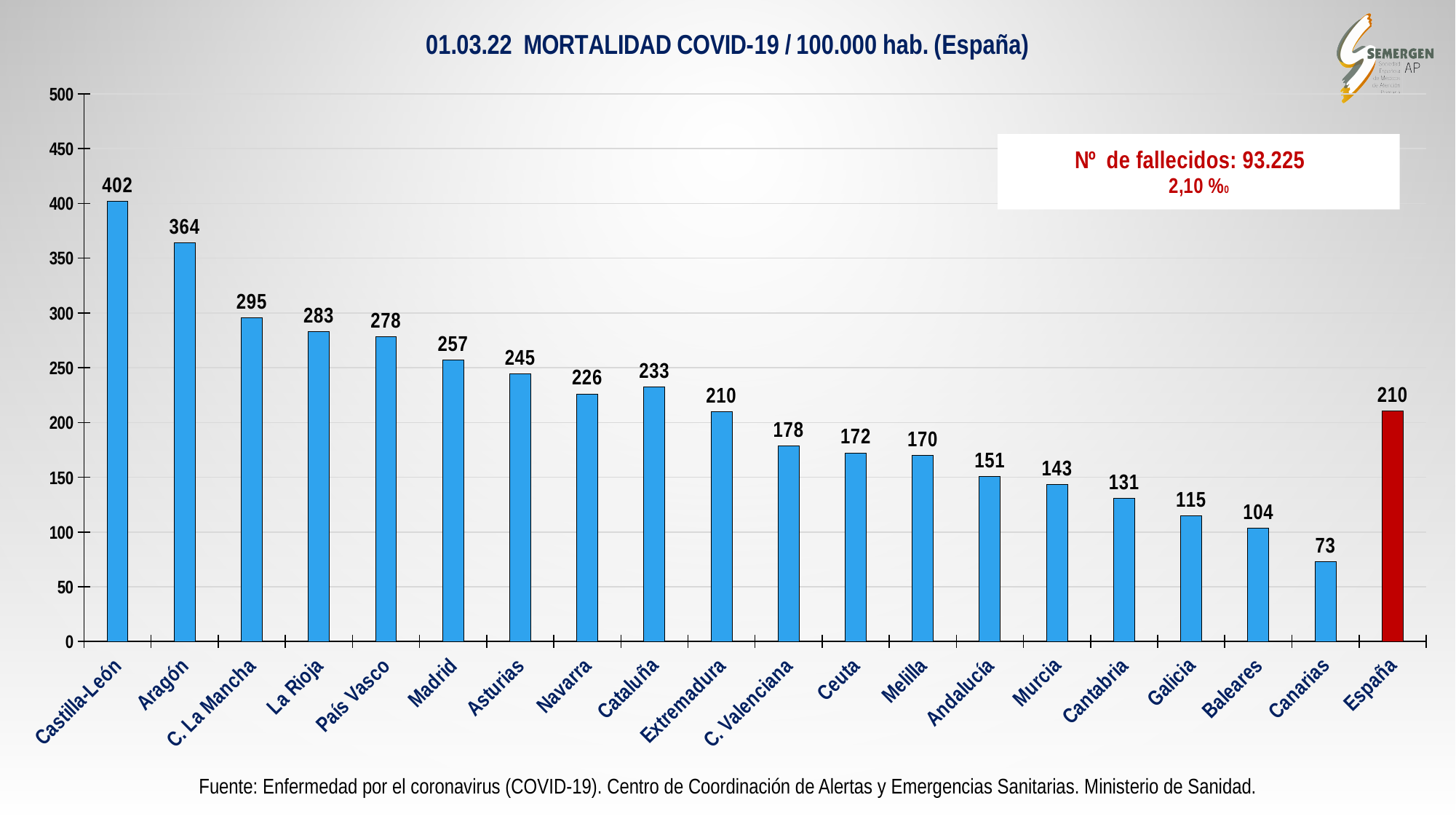
What is the difference between the values for Castilla-León and Aragón? 38 What is the difference between the values for Cataluña and Canarias? 160 Which has a higher value, País Vasco or Asturias? País Vasco Which region has the lowest mortality per 100,000 inhabitants? Canarias What is the COVID-19 mortality per 100,000 inhabitants for Madrid? 257 How many bars are shown in the chart? 20 Is the value for Andalucía greater or less than 200? less What is the total number of deaths (Nº de fallecidos) stated in the box on the chart? 93.225 What is the value shown for España (the red bar)? 210 What type of chart is shown on the slide? Bar chart What value is shown for Galicia? 115 Which region has the highest mortality per 100,000 inhabitants? Castilla-León